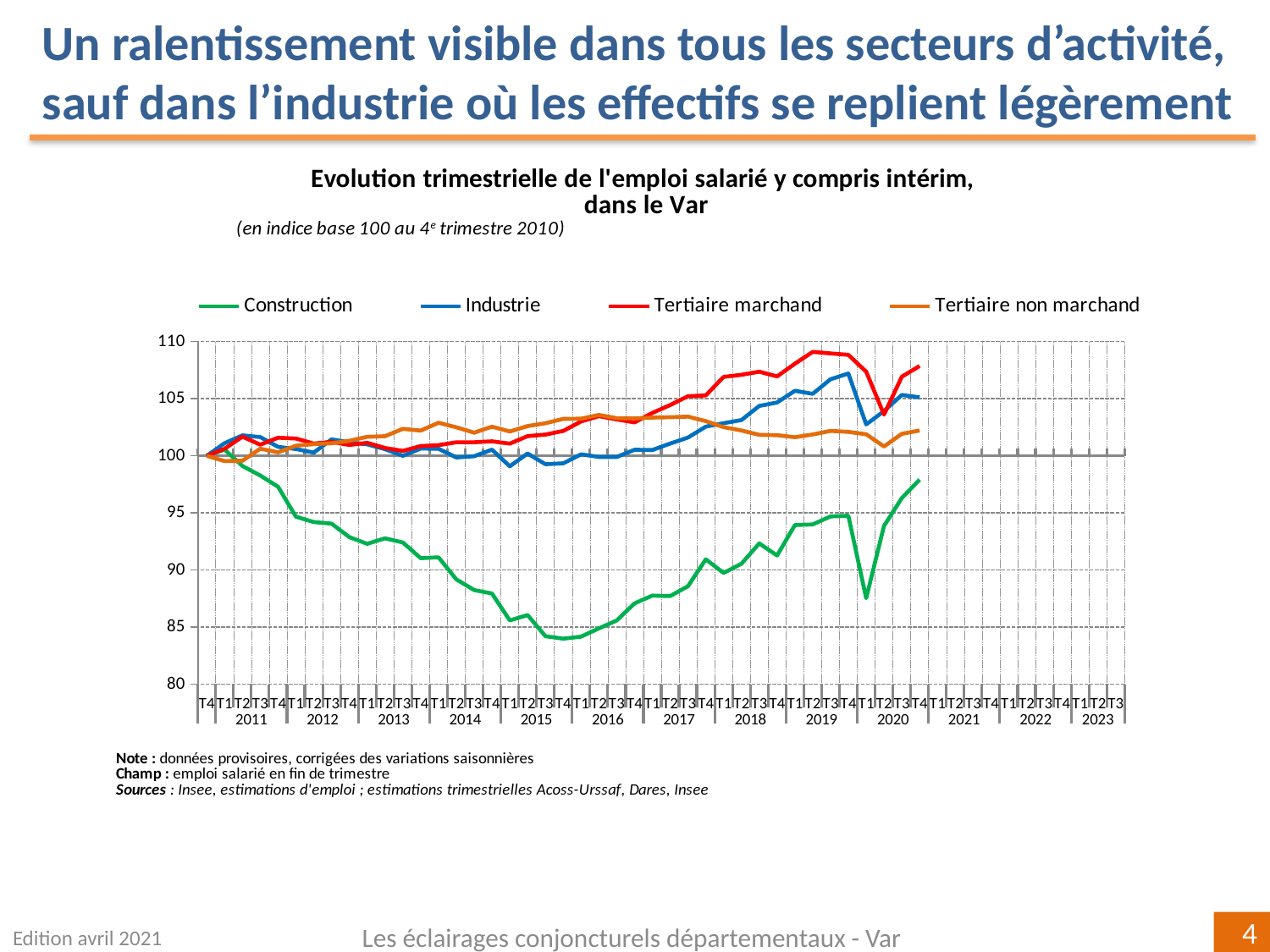
What kind of chart is shown on the slide? line chart Which series is plotted in orange? Tertiaire non marchand Which series has the lowest value at T4 2020? Construction Is the value for Tertiaire marchand at T3 2019 greater or less than 105? greater Is the value for Construction at T1 2020 greater or less than 90? less At T4 2019, which is larger: the value for Industrie or the value for Construction? Industrie Does the Construction series rise or fall between 2011 and 2015? fall How many series does the legend list? 4 Which series has the highest value at T4 2020? Tertiaire marchand Is the value for Construction at T4 2015 greater or less than 85? less What is the index value of all series at T4 2010, the base period? 100 Which series is plotted in green? Construction